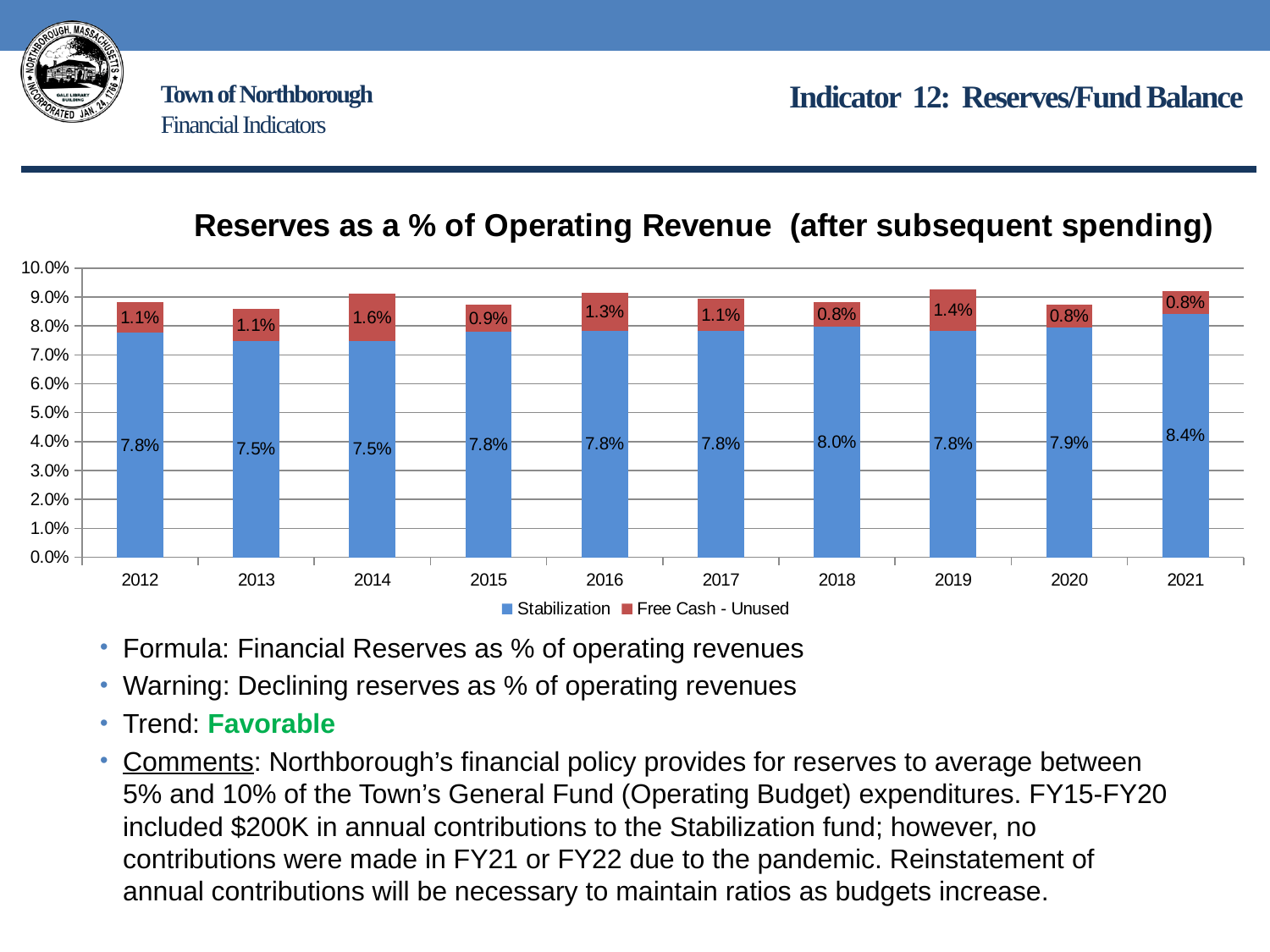
How many series does the legend list? 2 What is the Stabilization value for 2021? 8.4% Is the total height of the 2012 bar greater or less than 8.0%? greater What is the Free Cash - Unused value for 2014? 1.6% What is the total of the stacked bar for 2014? 9.1% Which is larger, the Free Cash - Unused value for 2014 or for 2015? 2014 How many years are shown on the x axis? 10 Which year has the highest Stabilization value? 2021 What kind of chart is shown on the slide? Stacked bar chart What is the difference between the Stabilization value in 2021 and in 2012? 0.6% Which year has the highest Free Cash - Unused value? 2014 What is the Stabilization value for 2018? 8.0%